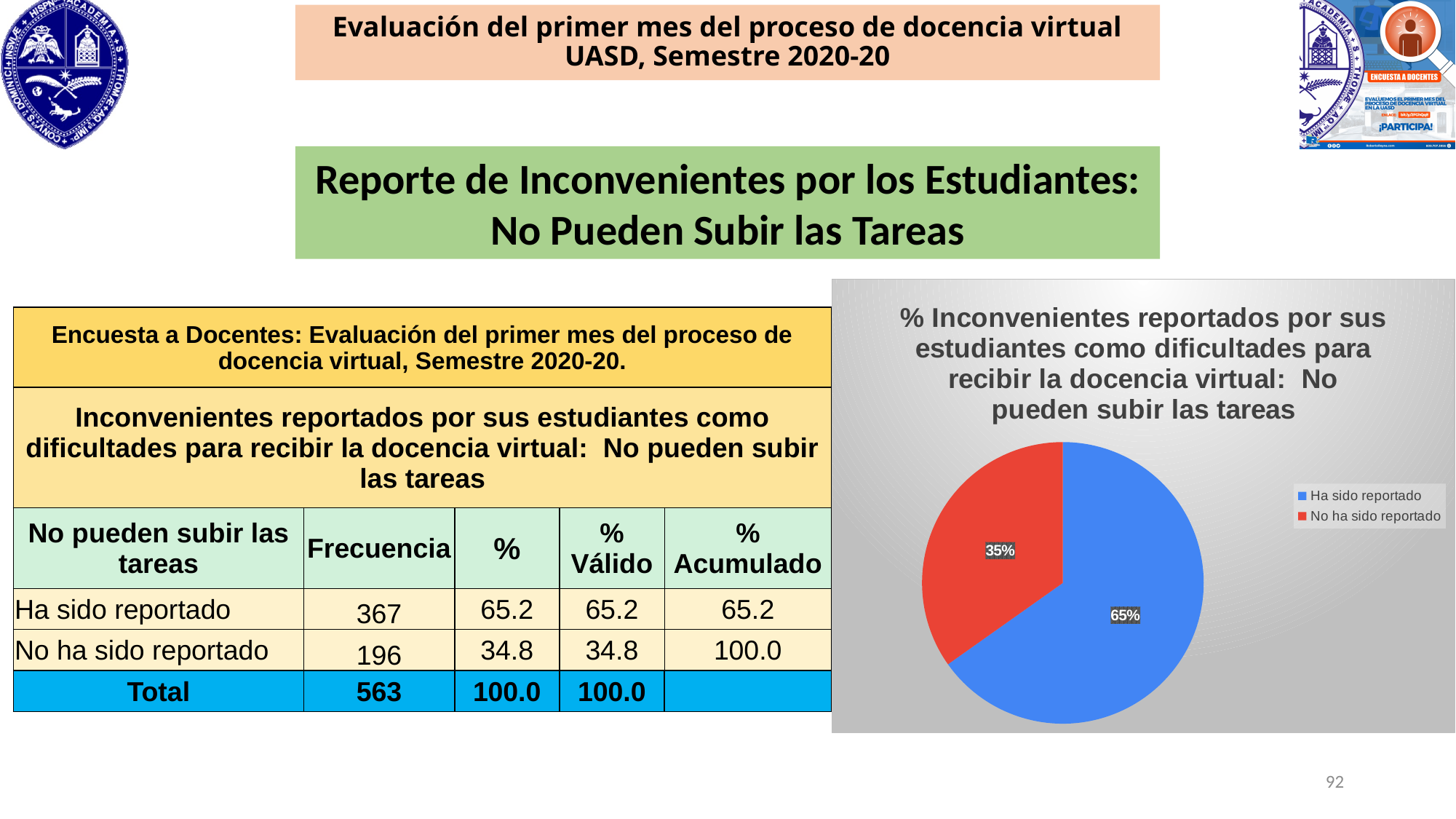
Which slice of the pie chart is the largest? Ha sido reportado Which slice of the pie chart is the smallest? No ha sido reportado How many slices does the pie chart have? 2 What colour is the "Ha sido reportado" slice in the pie chart? blue How many entries does the pie chart's legend list? 2 What percentage does the pie chart show for "Ha sido reportado"? 65% What kind of chart is shown on the slide? pie chart What is the difference in percentage points between the "Ha sido reportado" and "No ha sido reportado" slices in the pie chart? 30 In the pie chart, which is larger: "Ha sido reportado" or "No ha sido reportado"? Ha sido reportado What percentage does the pie chart show for "No ha sido reportado"? 35% What colour is the "No ha sido reportado" slice in the pie chart? red What share of the pie does the "No ha sido reportado" slice represent? 35%